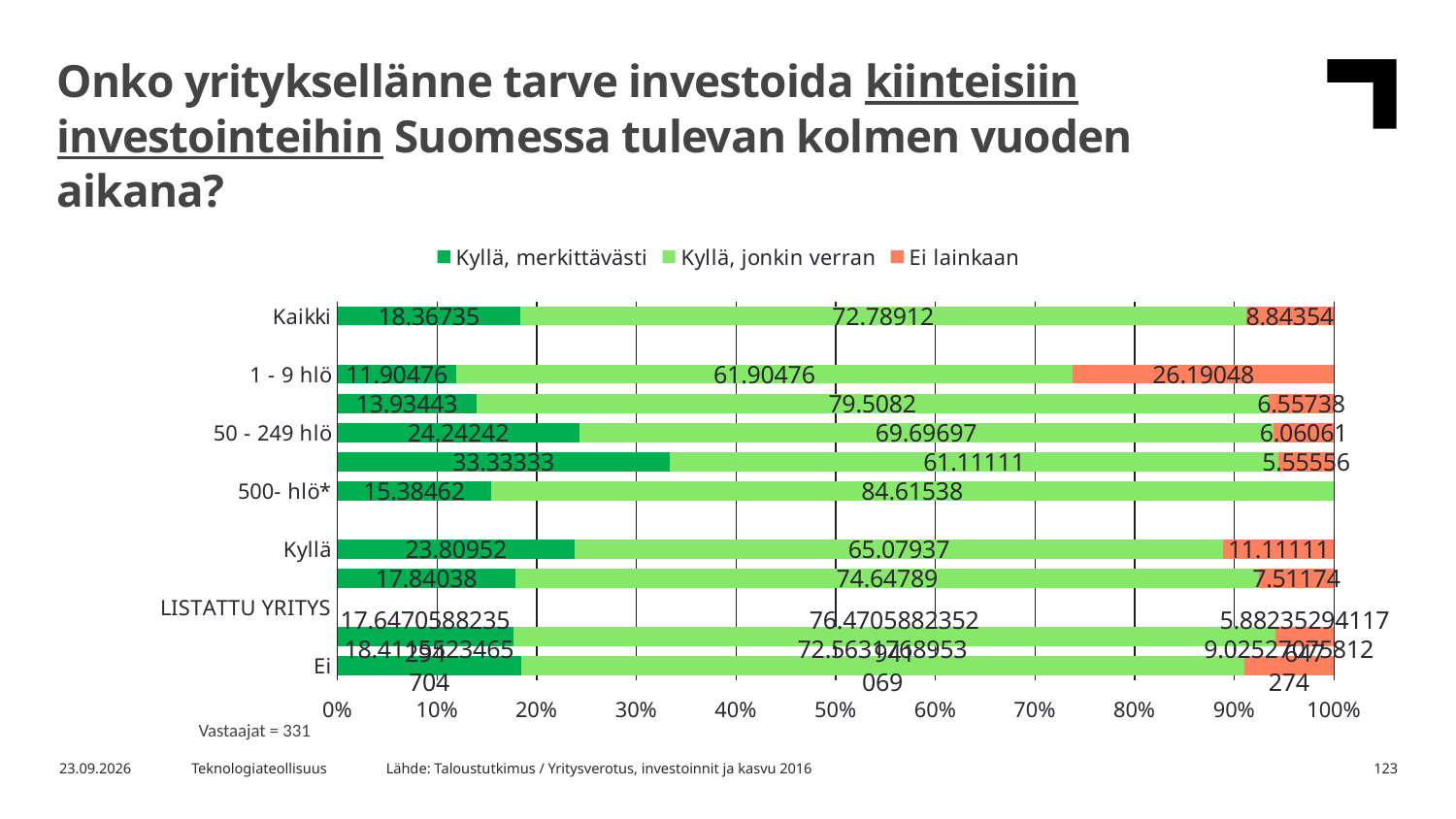
How many series does the legend list? 3 What is the first entry in the chart legend? Kyllä, merkittävästi What kind of chart is shown on the slide? Stacked bar chart Which has a larger "Ei lainkaan" value, Kaikki or 1 - 9 hlö? 1 - 9 hlö What is the value of "Ei lainkaan" for 1 - 9 hlö? 26.19048 What is the difference between the "Kyllä, merkittävästi" values for Kaikki and 1 - 9 hlö? 6.46259 What is the value of "Kyllä, jonkin verran" for 500- hlö*? 84.61538 What is the value of "Kyllä, merkittävästi" for 50 - 249 hlö? 24.24242 How many respondents (Vastaajat) does the chart note state? 331 Which category has the highest "Ei lainkaan" value? 1 - 9 hlö What is the value of "Ei lainkaan" for Kyllä? 11.11111 What is the value of "Kyllä, jonkin verran" for Kaikki? 72.78912